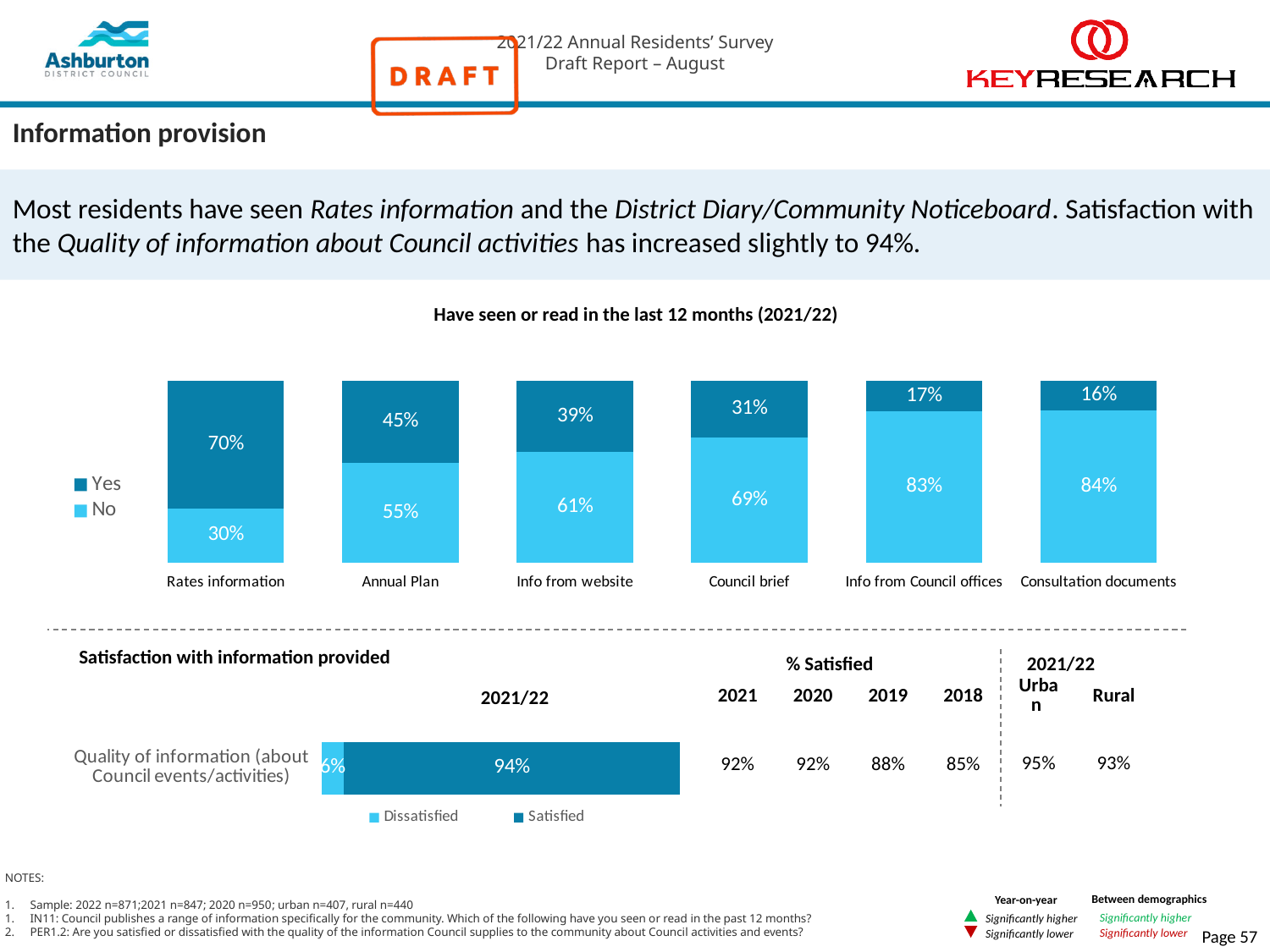
In the 'Have seen or read in the last 12 months (2021/22)' chart, what is the No value for Annual Plan? 55% How many categories are shown in the 'Have seen or read in the last 12 months (2021/22)' chart? 6 In the 'Have seen or read in the last 12 months (2021/22)' chart, which category has the highest Yes value? Rates information In the 'Have seen or read in the last 12 months (2021/22)' chart, which category has the lowest Yes value? Consultation documents In the 'Have seen or read in the last 12 months (2021/22)' chart, what is the difference between the Yes values for Rates information and Council brief? 39% In the 'Have seen or read in the last 12 months (2021/22)' chart, which has a larger Yes value, Annual Plan or Info from Council offices? Annual Plan What are the two legend entries in the 'Satisfaction with information provided' chart? Dissatisfied and Satisfied In the 'Satisfaction with information provided' chart, what percentage are Satisfied with the Quality of information (about Council events/activities) in 2021/22? 94% How many series does the legend of the 'Have seen or read in the last 12 months (2021/22)' chart list? 2 What kind of chart is the 'Have seen or read in the last 12 months (2021/22)' chart? Stacked bar chart In the 'Have seen or read in the last 12 months (2021/22)' chart, what percentage of residents said Yes for Rates information? 70% In the 'Have seen or read in the last 12 months (2021/22)' chart, what percentage said Yes for Info from website? 39%